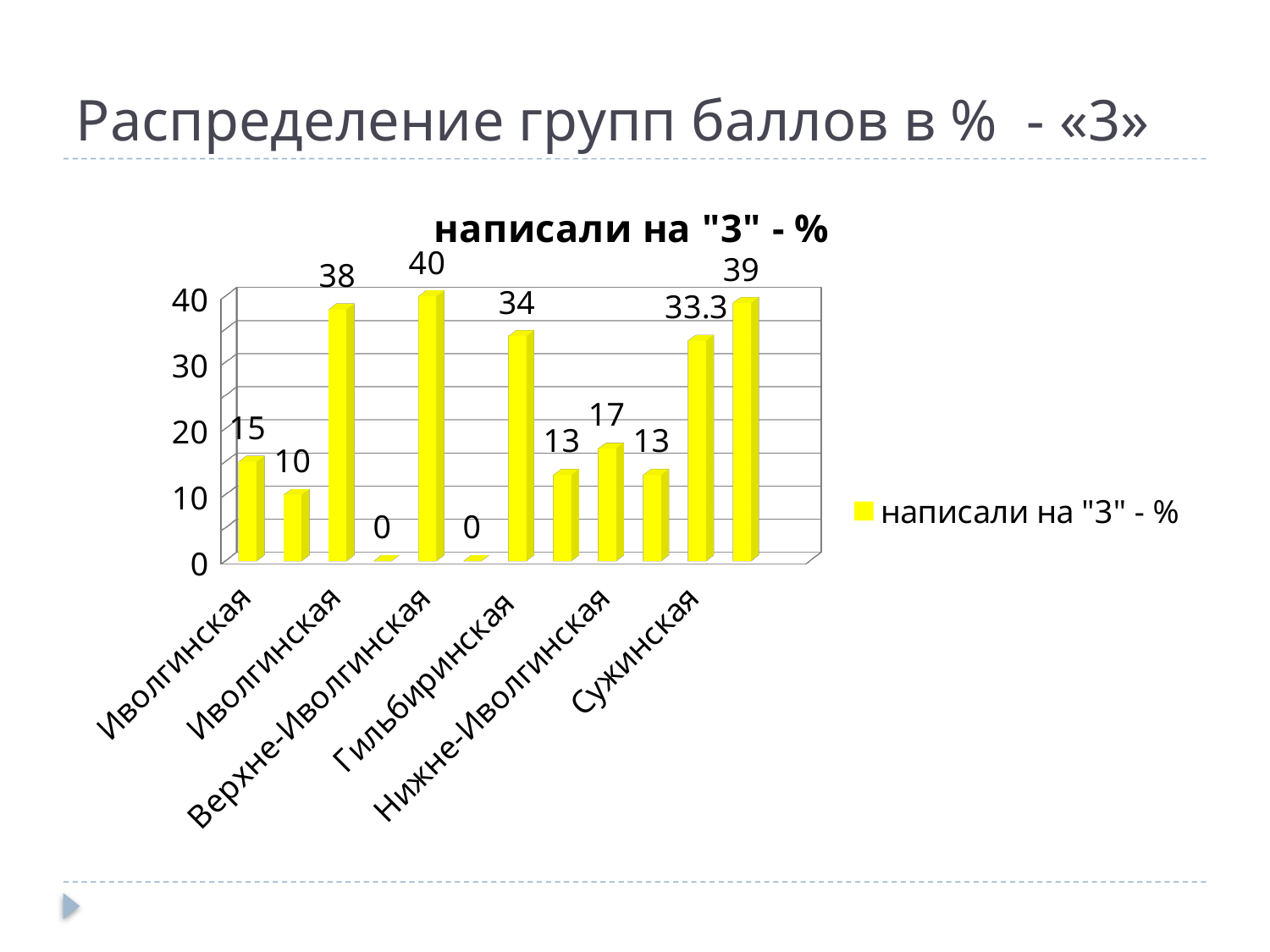
How many series does the legend list? 1 What is the value for Верхне-Иволгинская? 40 What is the highest value shown in the chart? 40 What is the title of the chart? написали на "3" - % What is the value for Гильбиринская? 34 What is the difference between the values for Верхне-Иволгинская and Гильбиринская? 6 What type of chart is shown on the slide? bar chart How many bars are plotted in the chart? 12 What is the value for Сужинская? 33.3 What is the lowest value shown in the chart? 0 Which is larger, the value for Сужинская or the value for Нижне-Иволгинская? Сужинская What is the value for Нижне-Иволгинская? 17